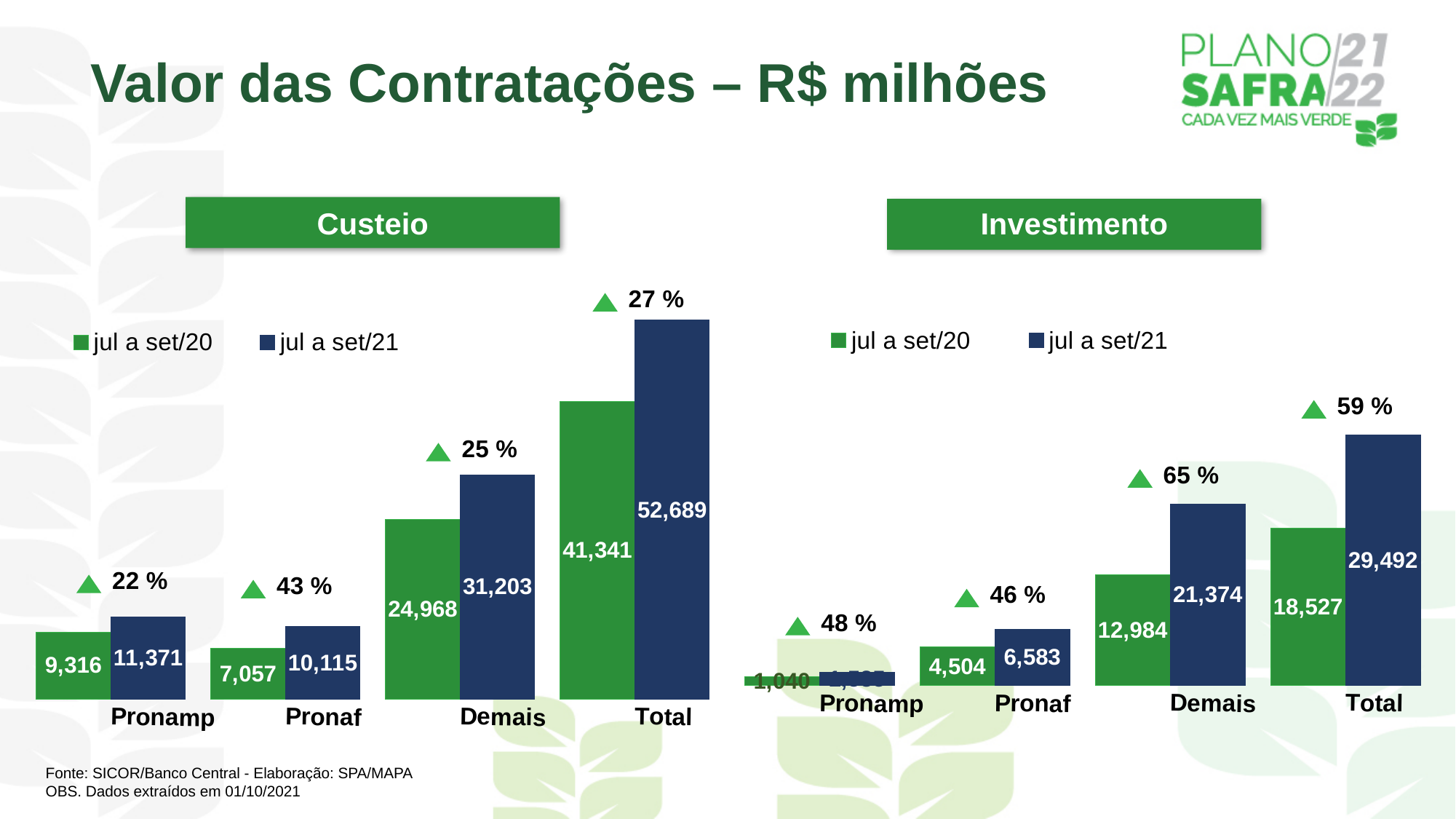
In the Investimento chart, what is the value for Pronaf in jul a set/20? 4,504 In the Custeio chart, which category has the lowest value in jul a set/20? Pronaf What type of chart is the Investimento chart? Bar chart In the Investimento chart, what is the difference between the jul a set/21 and jul a set/20 values for Total? 10,965 In the Investimento chart, what is the value for Demais in jul a set/21? 21,374 In the Custeio chart, what is the value for Pronaf in jul a set/20? 7,057 How many categories are shown on the x axis of the Investimento chart? 4 In the Custeio chart, what is the difference between the jul a set/21 and jul a set/20 values for Demais? 6,235 In the Investimento chart, which category has the highest value in jul a set/21? Total How many series does the legend of the Custeio chart list? 2 In the Custeio chart, what is the value for Total in jul a set/21? 52,689 In the Custeio chart, which is larger: Pronamp in jul a set/21 or Pronaf in jul a set/21? Pronamp in jul a set/21